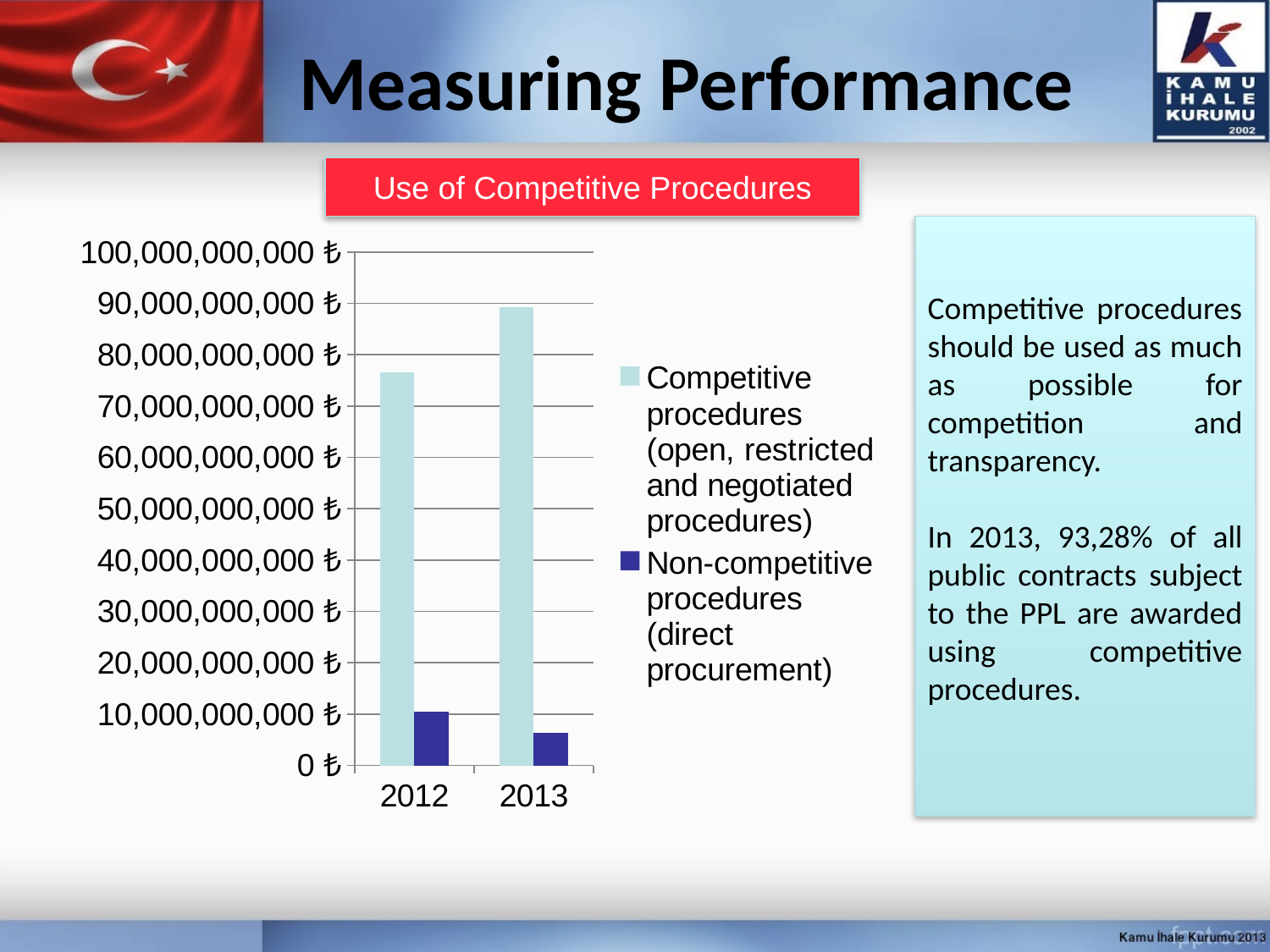
What is the title of the chart? Use of Competitive Procedures Is the value for competitive procedures in 2012 greater or less than 70,000,000,000 ₺? greater How many years are shown on the x axis of the chart? 2 Does the value for competitive procedures rise or fall from 2012 to 2013? Rise Which bar in the chart is the tallest? Competitive procedures in 2013 Which year has the higher value for competitive procedures, 2012 or 2013? 2013 How many series does the chart legend list? 2 Which year has the higher value for non-competitive procedures, 2012 or 2013? 2012 What type of chart is shown on the slide? Bar chart Is the value for competitive procedures in 2013 greater or less than 80,000,000,000 ₺? greater Is the value for non-competitive procedures in 2013 greater or less than 10,000,000,000 ₺? less